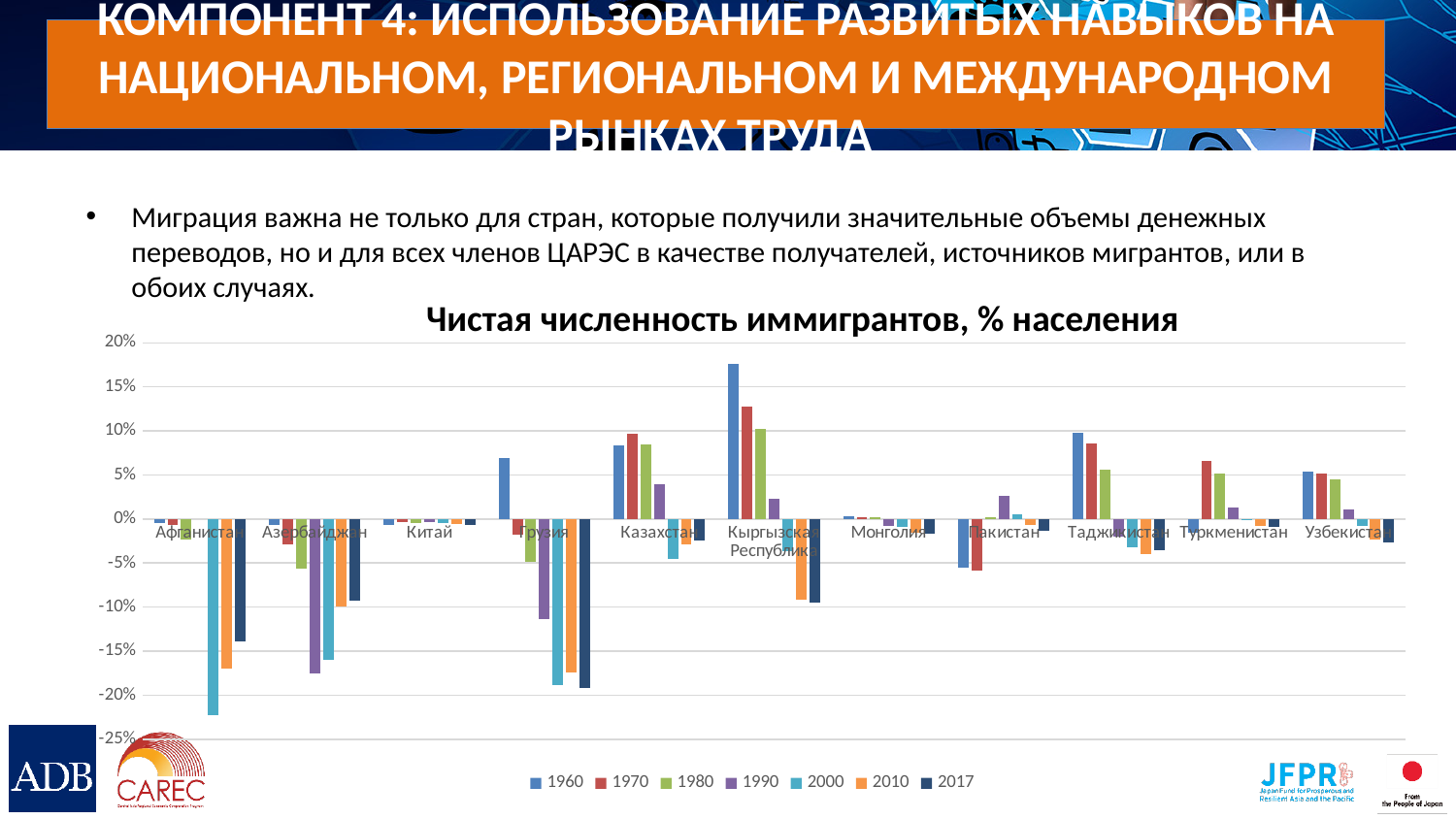
How many countries are shown on the x axis of the chart? 11 Which country has the highest 1960 value? Кыргызская Республика Do the values for Кыргызская Республика rise or fall from 1960 to 2017? fall What is the title of the chart? Чистая численность иммигрантов, % населения How many series does the chart legend list? 7 What kind of chart is shown on the slide? Bar chart Is the 2000 value for Афганистан greater or less than -20%? less Which is larger: the 1960 value for Кыргызская Республика or the 1960 value for Казахстан? Кыргызская Республика Is the 1960 value for Кыргызская Республика greater or less than 15%? greater Is the 1990 value for Азербайджан greater or less than -15%? less Which year is the first entry in the chart legend? 1960